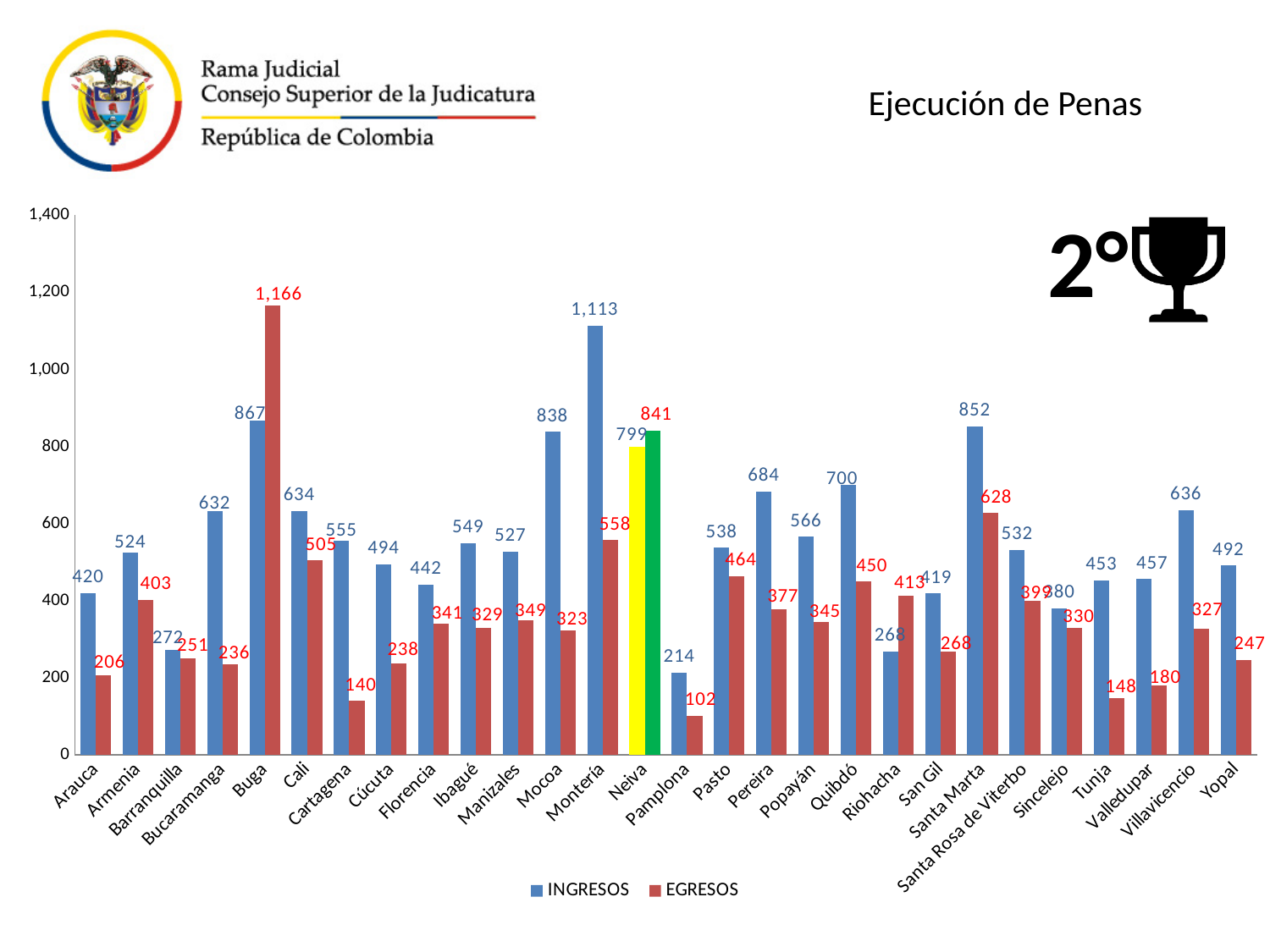
Which city has the lowest INGRESOS value? Pamplona How many series does the legend list? 2 Which city has the lowest EGRESOS value? Pamplona What is the INGRESOS value for Montería? 1,113 What kind of chart is shown on the slide? bar chart How many cities are shown on the x axis? 28 Which city has the highest INGRESOS value? Montería Which city has the highest EGRESOS value? Buga What is the difference between the EGRESOS and INGRESOS values for Neiva? 42 For Buga, which is larger, INGRESOS or EGRESOS? EGRESOS What is the EGRESOS value for Buga? 1,166 What are the two series named in the legend? INGRESOS and EGRESOS